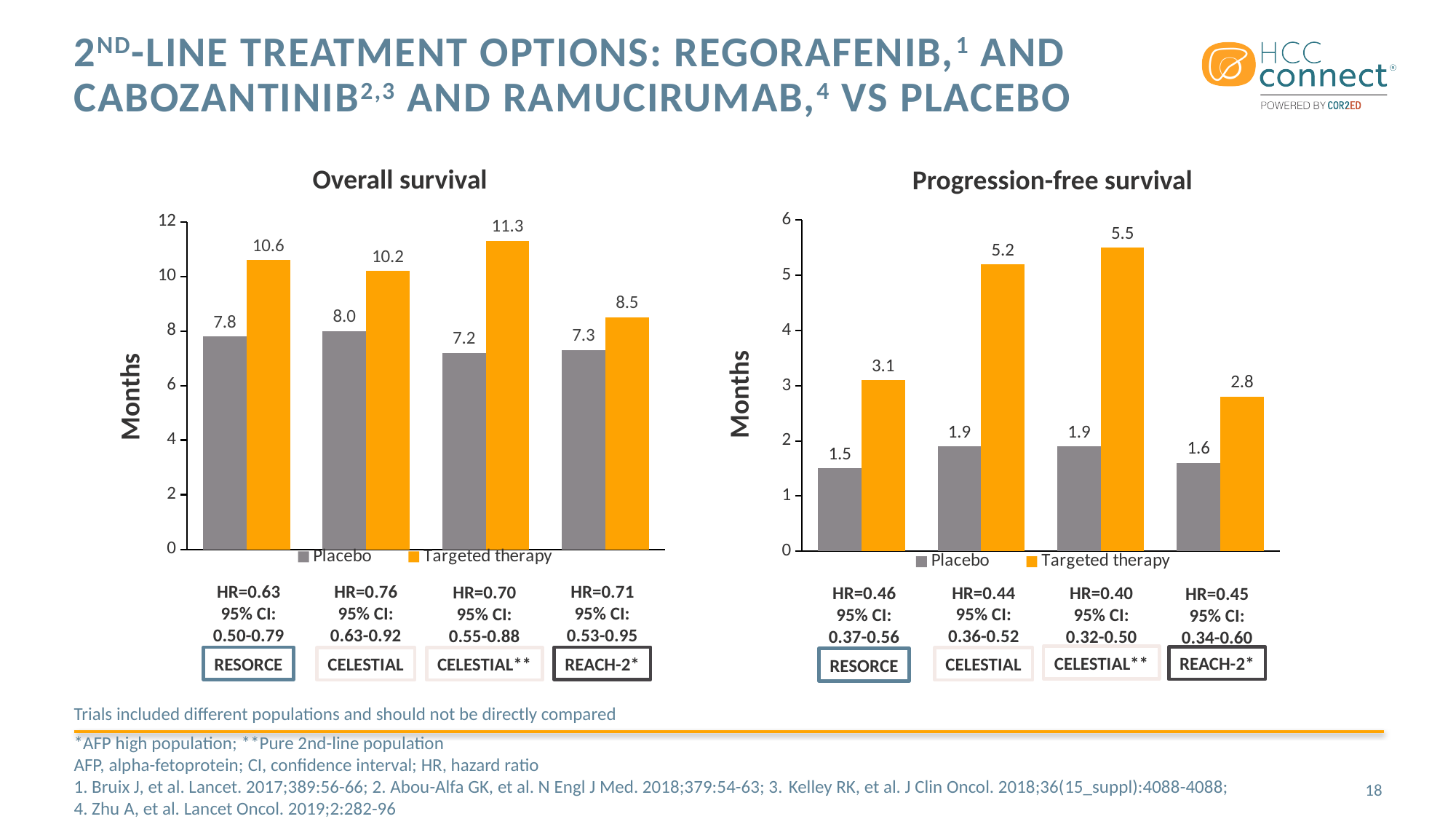
What kind of chart is the Progression-free survival chart? Bar chart How many trials are shown on the x axis of the Progression-free survival chart? 4 In the Progression-free survival chart, what is the Targeted therapy value for REACH-2*? 2.8 In the Overall survival chart, what is the difference between the Targeted therapy and Placebo values for REACH-2*? 1.2 In the Overall survival chart, which is larger: the Placebo value for CELESTIAL or the Placebo value for RESORCE? CELESTIAL In the Overall survival chart, what is the Targeted therapy value for RESORCE? 10.6 In the Overall survival chart, what is the Placebo value for CELESTIAL**? 7.2 In the Progression-free survival chart, which trial has the lowest Targeted therapy value? REACH-2* In the Progression-free survival chart, what is the difference between the Targeted therapy and Placebo values for CELESTIAL**? 3.6 How many series does the legend of the Overall survival chart list? 2 In the Overall survival chart, which trial has the highest Targeted therapy value? CELESTIAL** In the Progression-free survival chart, what is the Placebo value for RESORCE? 1.5